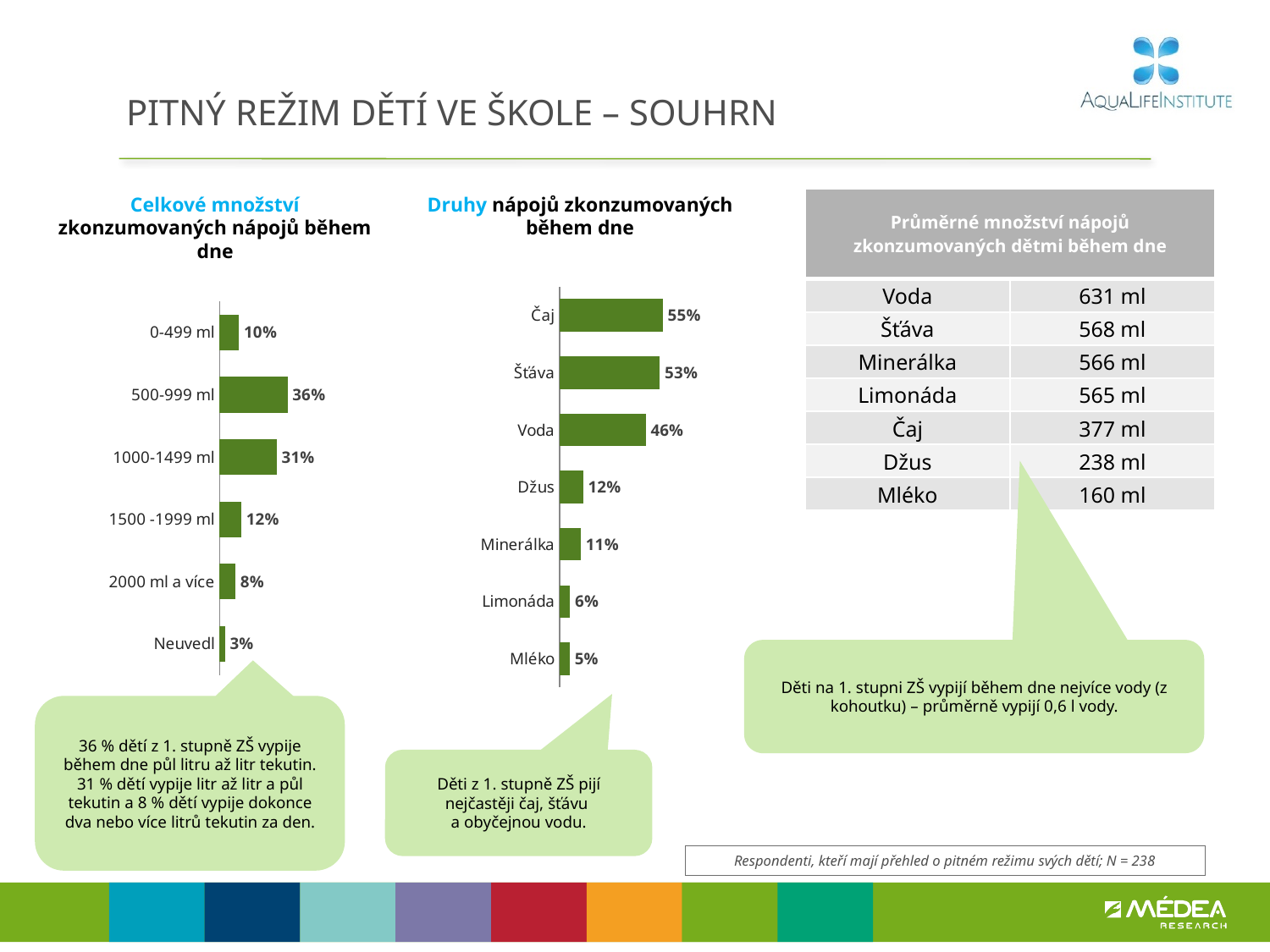
In the chart 'Celkové množství zkonzumovaných nápojů během dne', which category has the highest value? 500-999 ml In the chart 'Celkové množství zkonzumovaných nápojů během dne', what is the value for 500-999 ml? 36% In the chart 'Druhy nápojů zkonzumovaných během dne', which is larger, the value for Džus or the value for Limonáda? Džus In the chart 'Celkové množství zkonzumovaných nápojů během dne', how many categories are shown? 6 In the chart 'Celkové množství zkonzumovaných nápojů během dne', what is the value for 2000 ml a více? 8% In the chart 'Druhy nápojů zkonzumovaných během dne', which drink has the highest value? Čaj In the chart 'Druhy nápojů zkonzumovaných během dne', what is the value for Voda? 46% What kind of chart is 'Druhy nápojů zkonzumovaných během dne'? Bar chart In the chart 'Celkové množství zkonzumovaných nápojů během dne', which category has the lowest value? Neuvedl In the chart 'Druhy nápojů zkonzumovaných během dne', how many drink categories are shown? 7 In the chart 'Celkové množství zkonzumovaných nápojů během dne', what is the difference between the values for 500-999 ml and 1000-1499 ml? 5% In the chart 'Druhy nápojů zkonzumovaných během dne', which drink has the lowest value? Mléko